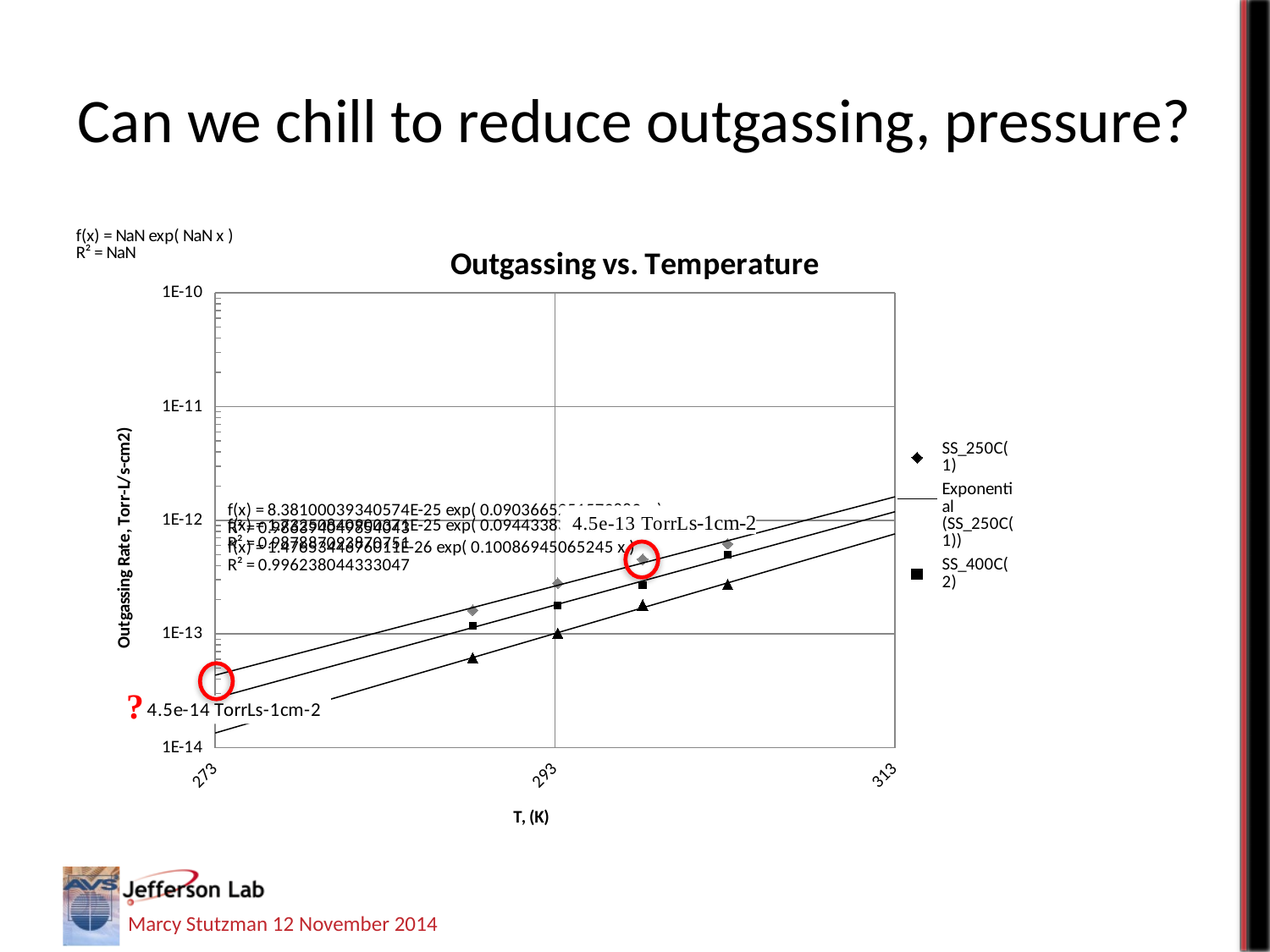
What is the highest value labelled on the y axis? 1E-10 What is the label of the x axis? T, (K) Is the SS_250C(1) value at 293 K greater or less than 1E-12? less What is the title of the chart? Outgassing vs. Temperature At 293 K, which series has the larger value, SS_250C(1) or SS_400C(2)? SS_250C(1) How many tick labels are shown on the x axis? 3 What kind of chart is shown on the slide? scatter chart Is the SS_400C(2) value at 293 K greater or less than 1E-12? less Do the outgassing rate values rise or fall as temperature increases along the x axis? rise Is the SS_250C(1) value at 293 K greater or less than 1E-13? greater How many entries does the chart legend list? 3